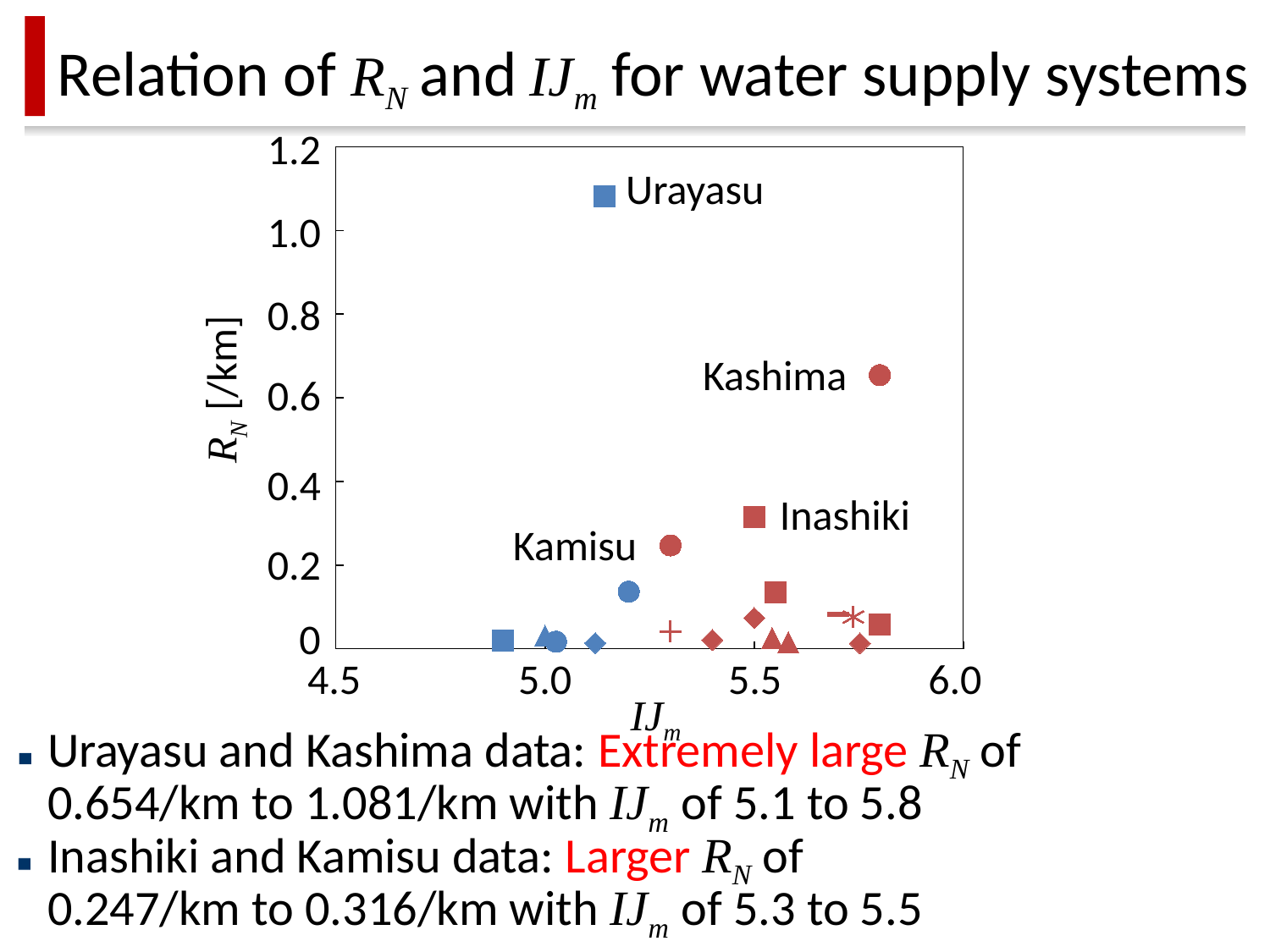
Which has a larger R_N value, Kashima or Inashiki? Kashima Which labeled point has the lowest R_N value among the four named points? Kamisu Is the IJ_m value for Kamisu greater or less than 5.5? less Which labeled point has the highest R_N value? Urayasu Which labeled point has the largest IJ_m value? Kashima Which labeled point has the smallest IJ_m value? Urayasu Is the R_N value for Urayasu greater or less than 1.0? greater Is the R_N value for Kashima greater or less than 0.6? greater What kind of chart is shown on the slide? scatter chart How many points on the chart are labeled with a name? 4 What is the label of the vertical axis? R_N [/km]